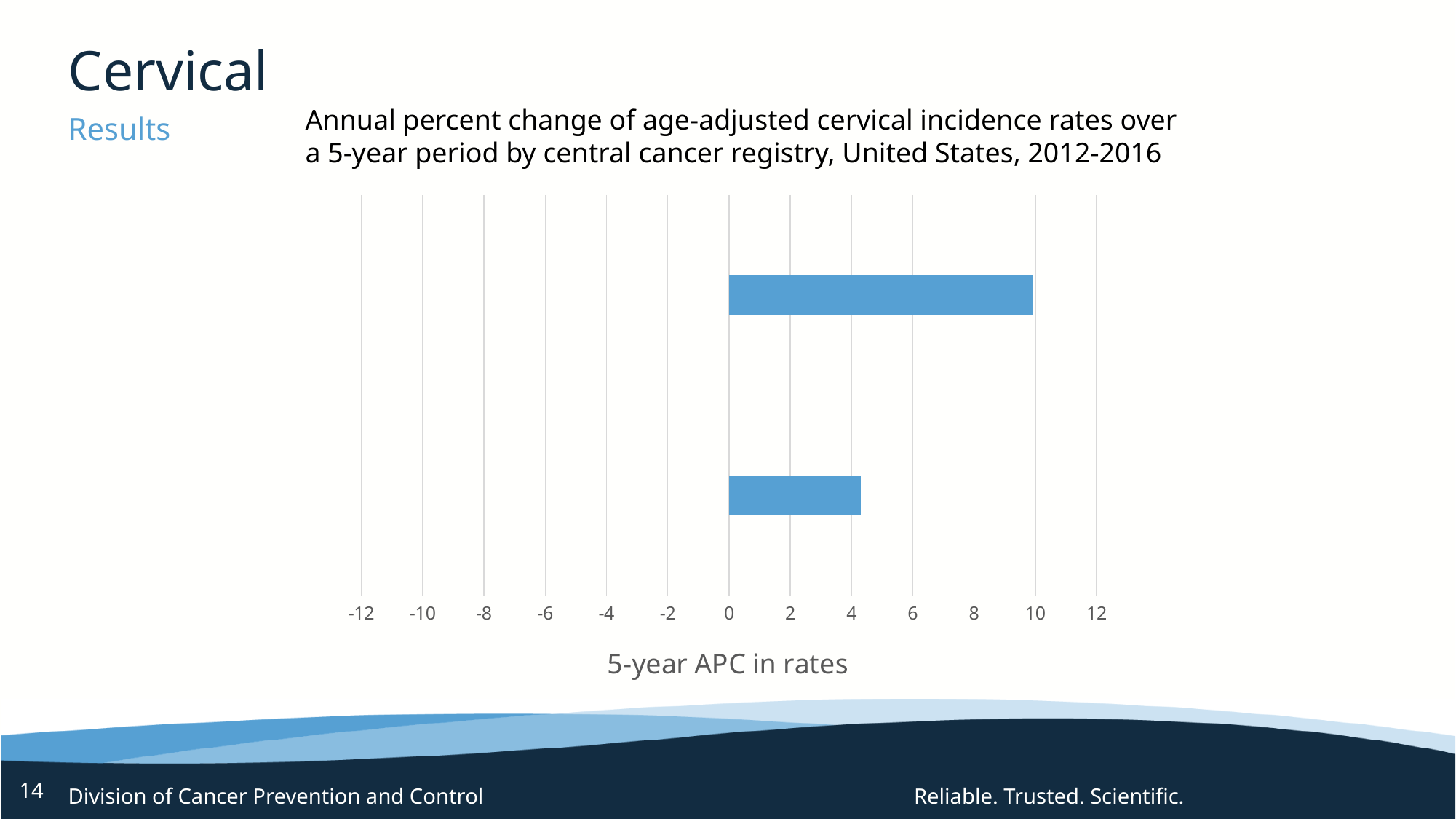
How many bars are plotted in the chart? 2 Is the value for the bottom bar greater or less than 6? less What is the label of the x axis? 5-year APC in rates Is the value for the top bar greater or less than 0? greater Which bar is longer, the top bar or the bottom bar? the top bar What kind of chart is shown on the slide? bar chart What is the lowest value shown on the x axis? -12 Are the plotted values positive or negative? positive Is the value for the top bar greater or less than 8? greater